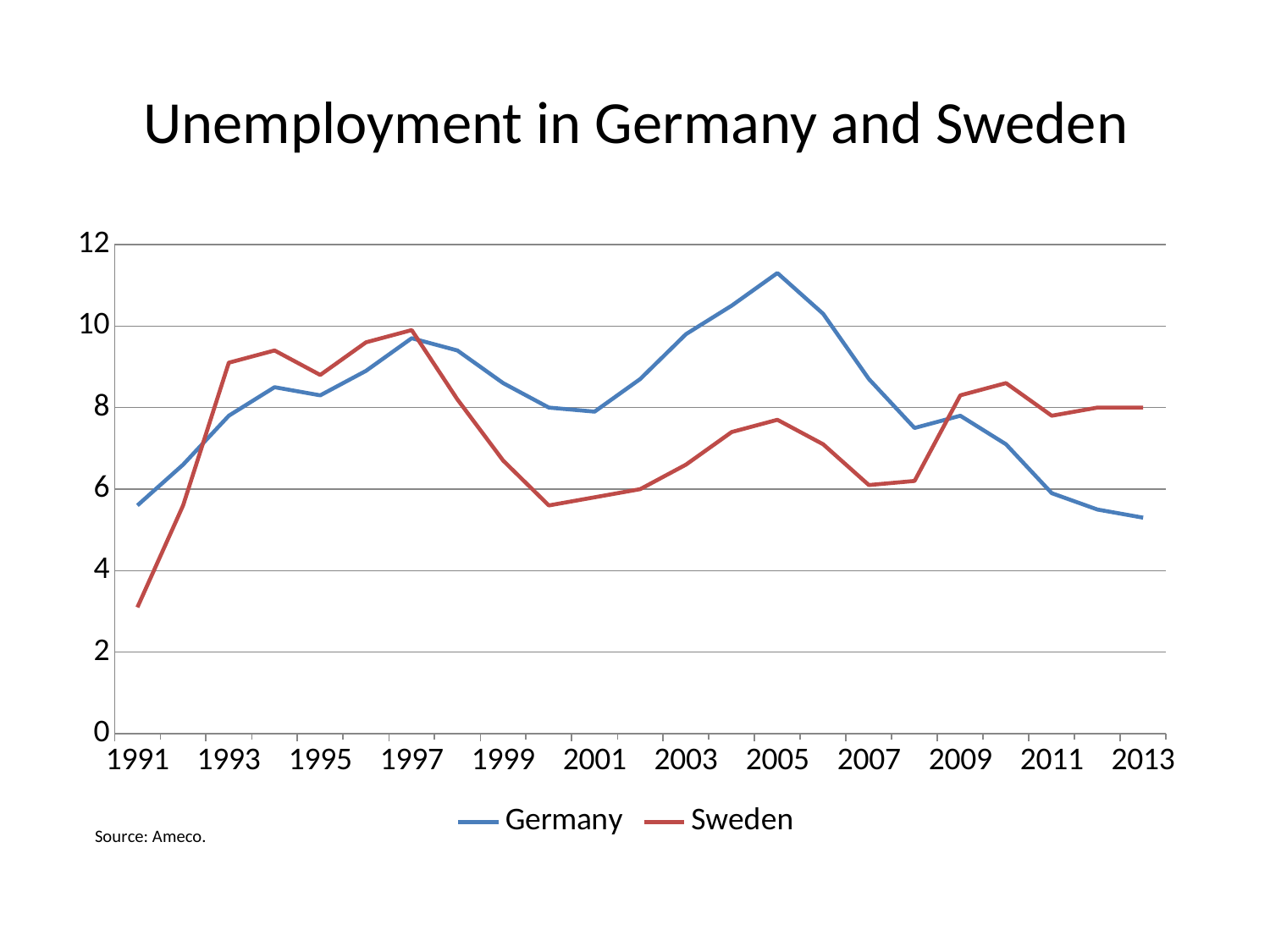
In which year does the Germany line reach its highest value? 2005 What kind of chart is shown on the slide? line chart In 2005, which country has the higher unemployment value, Germany or Sweden? Germany Is the value for Germany in 2005 greater or less than 10? greater In which year does the Sweden line reach its lowest value? 1991 In which year does the Sweden line reach its highest value? 1997 Which two countries are listed in the legend? Germany and Sweden How many series does the legend list? 2 Is the value for Sweden in 1991 greater or less than 4? less In 2013, which country has the higher unemployment value, Germany or Sweden? Sweden Does the Germany line rise or fall between 2009 and 2013? fall What is the title of the chart? Unemployment in Germany and Sweden